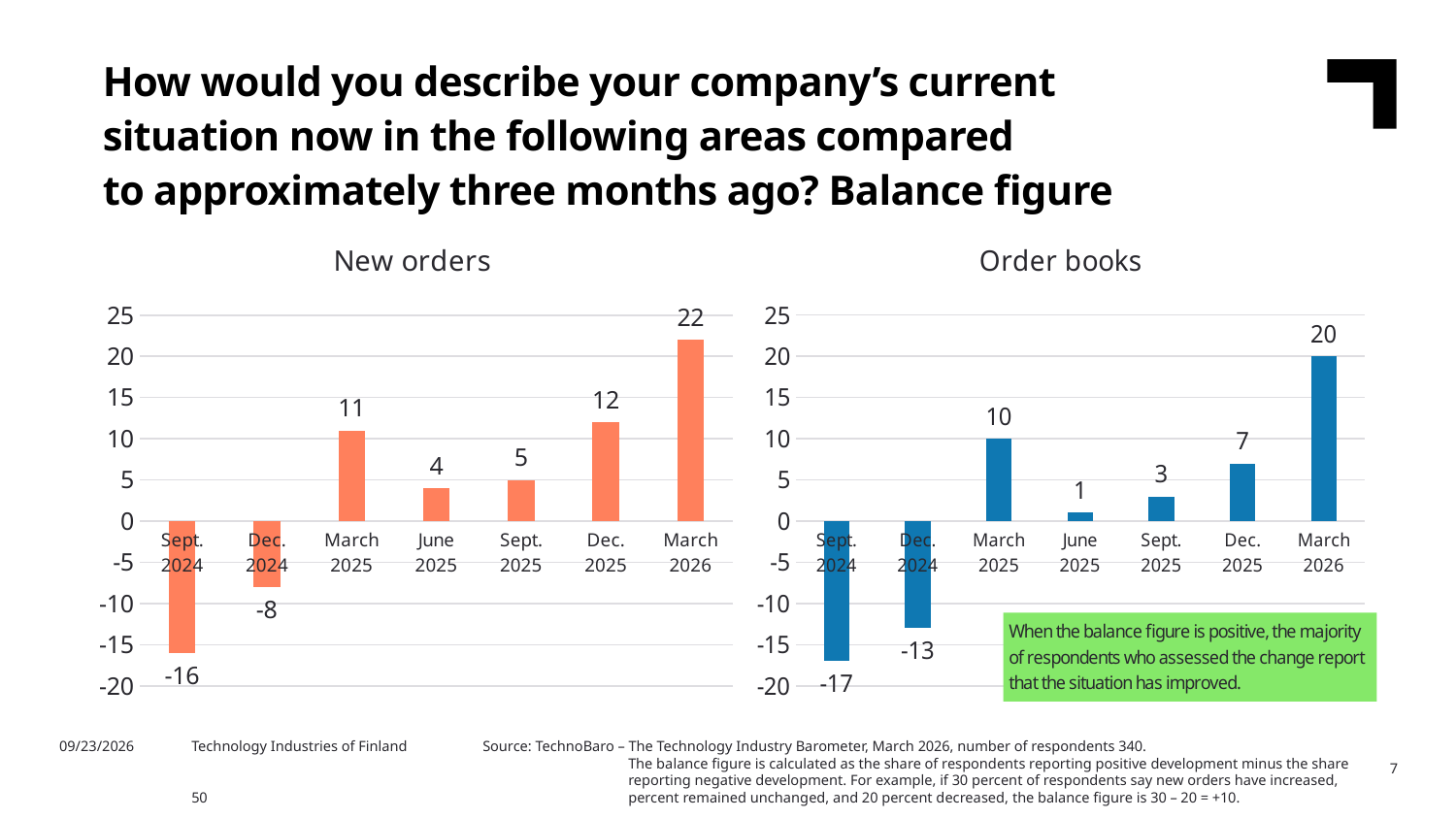
How many periods are shown on the x axis of the New orders chart? 7 In the Order books chart, what is the balance figure for Dec. 2024? -13 What kind of chart is the Order books chart? Bar chart What is the title of the chart on the left side of the slide? New orders In the New orders chart, what is the difference between the balance figures for March 2026 and Dec. 2025? 10 In the New orders chart, what is the balance figure for June 2025? 4 In the New orders chart, what is the balance figure for March 2026? 22 In the Order books chart, what is the balance figure for June 2025? 1 In the Order books chart, which is larger, the balance figure for March 2025 or Dec. 2025? March 2025 In the New orders chart, which period has the lowest balance figure? Sept. 2024 In the Order books chart, which period has the highest balance figure? March 2026 In the Order books chart, what is the difference between the balance figures for March 2026 and Sept. 2024? 37